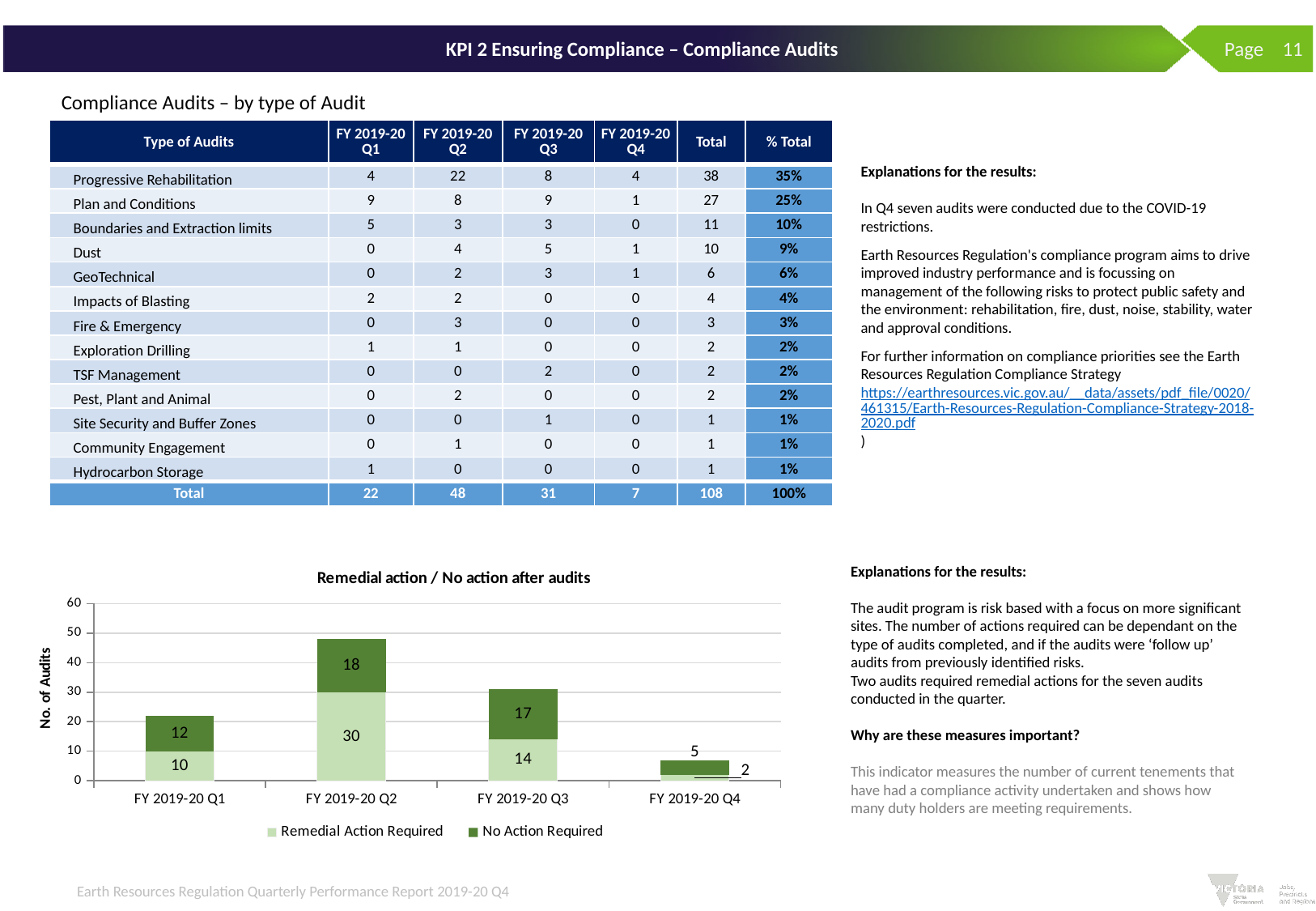
What kind of chart is 'Remedial action / No action after audits'? Stacked bar chart In the chart 'Remedial action / No action after audits', which is larger in FY 2019-20 Q1: Remedial Action Required or No Action Required? No Action Required In the chart 'Remedial action / No action after audits', what is the difference between Remedial Action Required and No Action Required in FY 2019-20 Q2? 12 In the chart 'Remedial action / No action after audits', what is the total height of the stacked bar for FY 2019-20 Q3? 31 In the chart 'Remedial action / No action after audits', what is the value for Remedial Action Required in FY 2019-20 Q2? 30 In the chart 'Remedial action / No action after audits', which quarter has the highest value for Remedial Action Required? FY 2019-20 Q2 In the chart 'Remedial action / No action after audits', what is the value for No Action Required in FY 2019-20 Q4? 5 How many series does the legend of the chart 'Remedial action / No action after audits' list? 2 In the chart 'Remedial action / No action after audits', what is the total height of the stacked bar for FY 2019-20 Q2? 48 In the chart 'Remedial action / No action after audits', what is the value for No Action Required in FY 2019-20 Q3? 17 In the chart 'Remedial action / No action after audits', which quarter has the lowest value for No Action Required? FY 2019-20 Q4 How many quarters are shown on the x axis of the chart 'Remedial action / No action after audits'? 4